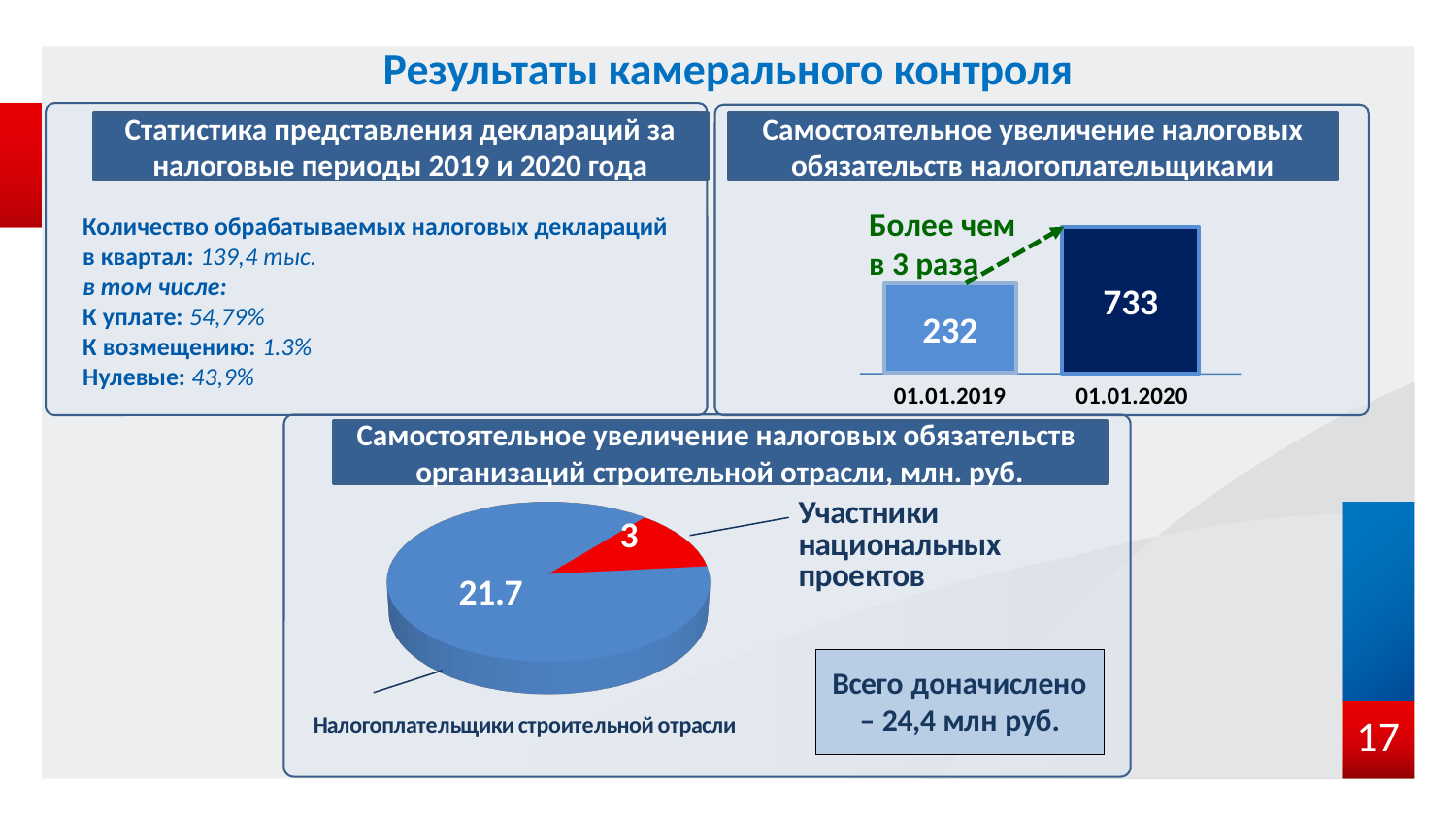
What type of chart is shown at the bottom of the slide? Pie chart In the pie chart at the bottom of the slide, what colour is the slice for 'Участники национальных проектов'? Red What type of chart is shown on the top right of the slide? Bar chart In the chart titled 'Самостоятельное увеличение налоговых обязательств налогоплательщиками', what is the value for 01.01.2020? 733 In the bar chart on the top right, what is the difference between the values for 01.01.2020 and 01.01.2019? 501 In the chart titled 'Самостоятельное увеличение налоговых обязательств налогоплательщиками', what is the value for 01.01.2019? 232 In the bar chart on the top right, do the values rise or fall from 01.01.2019 to 01.01.2020? Rise In the bar chart on the top right, which date has the higher value? 01.01.2020 In the pie chart at the bottom of the slide, which category has the larger slice? Налогоплательщики строительной отрасли In the pie chart at the bottom of the slide, what is the value for 'Участники национальных проектов'? 3 In the bar chart on the top right, how many bars are plotted? 2 In the chart titled 'Самостоятельное увеличение налоговых обязательств организаций строительной отрасли, млн. руб.', what is the value for 'Налогоплательщики строительной отрасли'? 21.7